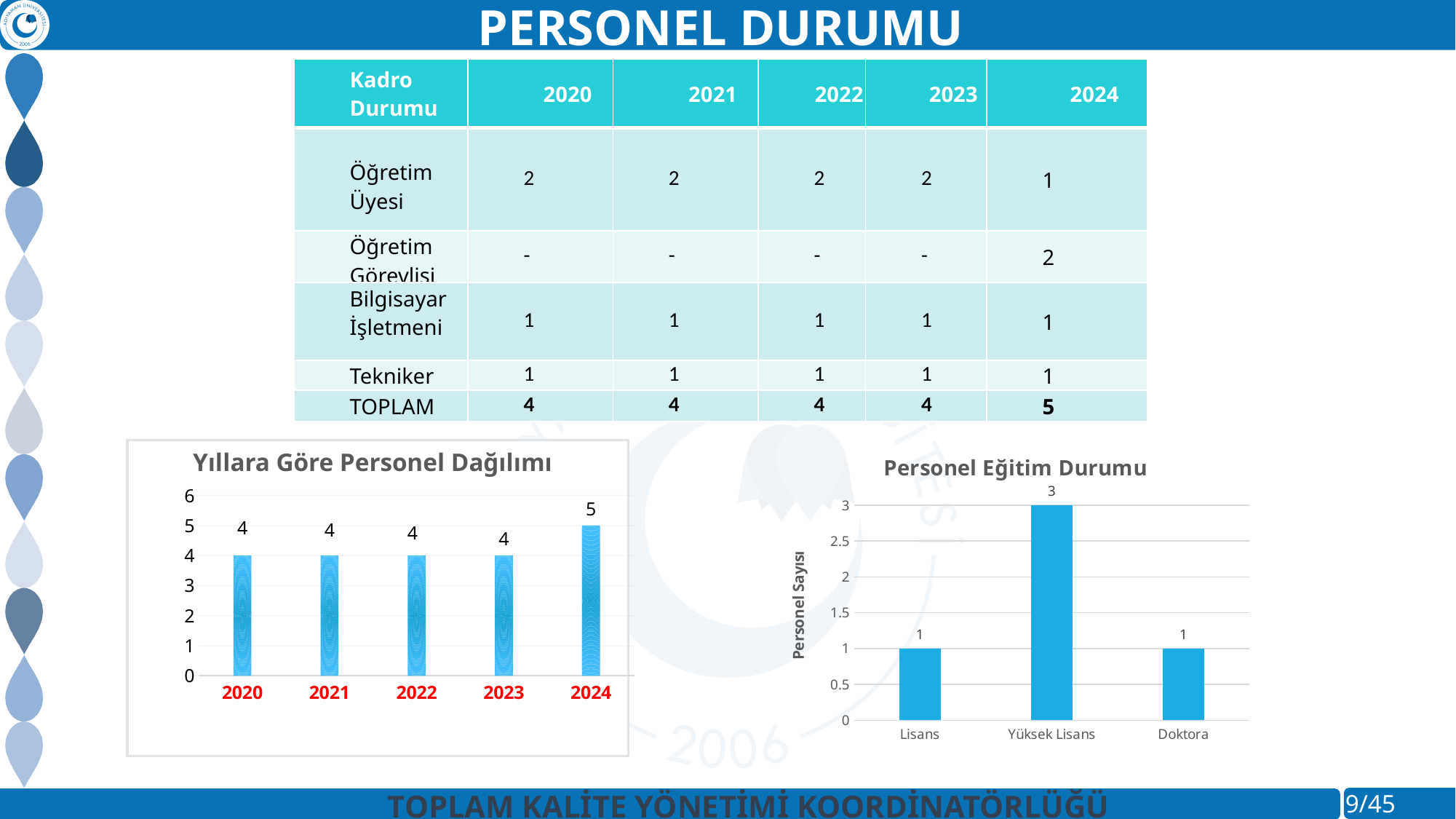
What is the y-axis label of the 'Personel Eğitim Durumu' chart? Personel Sayısı In the 'Yıllara Göre Personel Dağılımı' chart, what is the value for 2021? 4 In the 'Personel Eğitim Durumu' chart, what is the difference between Yüksek Lisans and Doktora? 2 In the 'Personel Eğitim Durumu' chart, what is the value for Yüksek Lisans? 3 In the 'Yıllara Göre Personel Dağılımı' chart, which year has the highest value? 2024 In the 'Personel Eğitim Durumu' chart, is the value for Yüksek Lisans larger than the value for Lisans? Yes In the 'Yıllara Göre Personel Dağılımı' chart, how many years are shown on the x axis? 5 In the 'Personel Eğitim Durumu' chart, which category has the highest value? Yüksek Lisans In the 'Yıllara Göre Personel Dağılımı' chart, what is the value for 2024? 5 In the 'Yıllara Göre Personel Dağılımı' chart, what is the difference between the values for 2024 and 2023? 1 What kind of chart is 'Yıllara Göre Personel Dağılımı'? bar chart In the 'Personel Eğitim Durumu' chart, what is the value for Doktora? 1